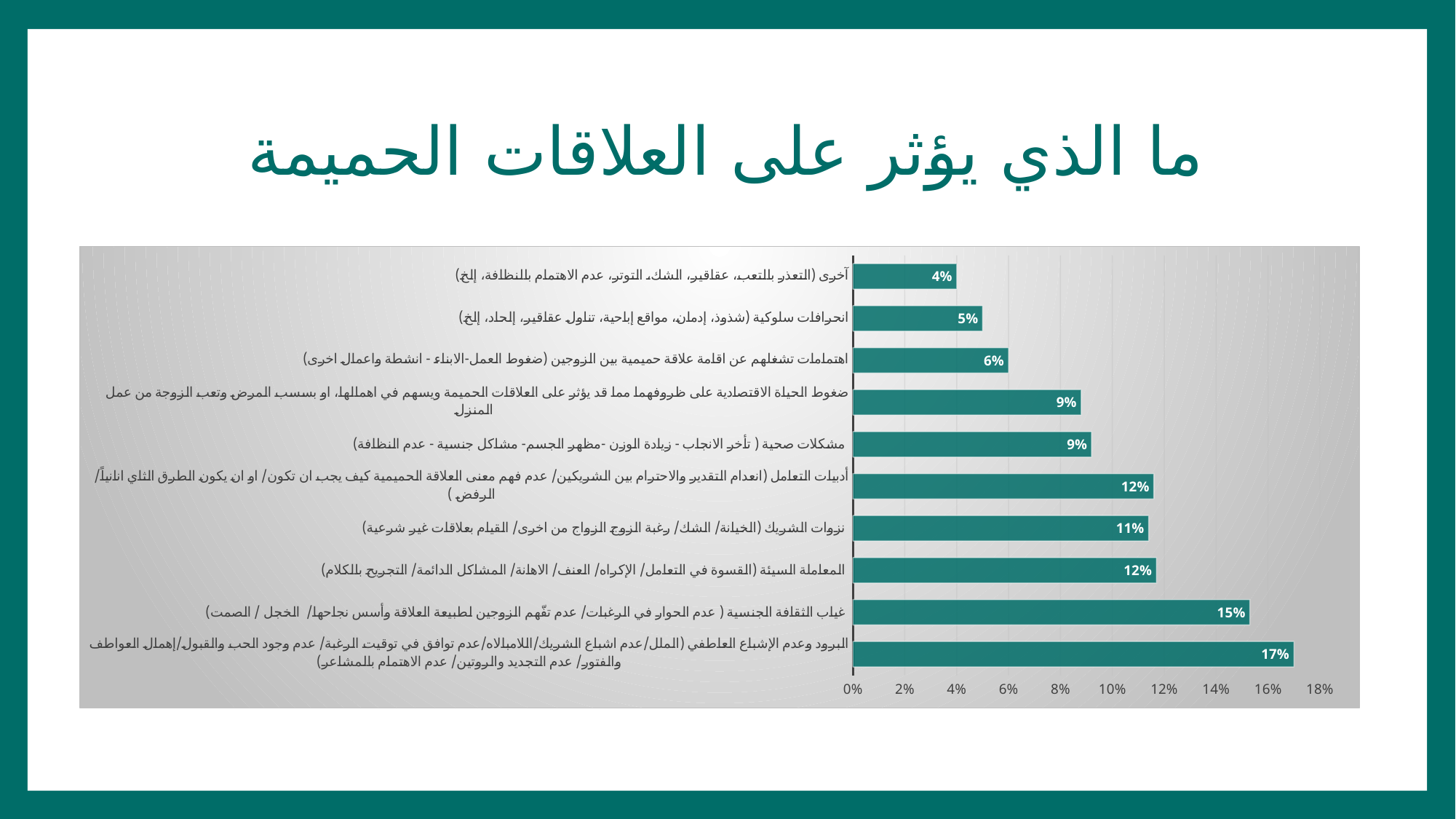
What is the value for "انحرافات سلوكية"? 5% Which is larger: the value for "المعاملة السيئة" or the value for "نزوات الشريك"? المعاملة السيئة What type of chart is shown on the slide? bar chart What is the value for "نزوات الشريك"? 11% What is the value for "غياب الثقافة الجنسية"? 15% How many categories (bars) does the chart show? 10 Which category has the highest value? البرود وعدم الإشباع العاطفي What is the value for "البرود وعدم الإشباع العاطفي"? 17% What is the value for "مشكلات صحية"? 9% What is the difference between the values for "البرود وعدم الإشباع العاطفي" and "غياب الثقافة الجنسية"? 2% What is the title of the slide? ما الذي يؤثر على العلاقات الحميمة Which category has the lowest value? أخرى